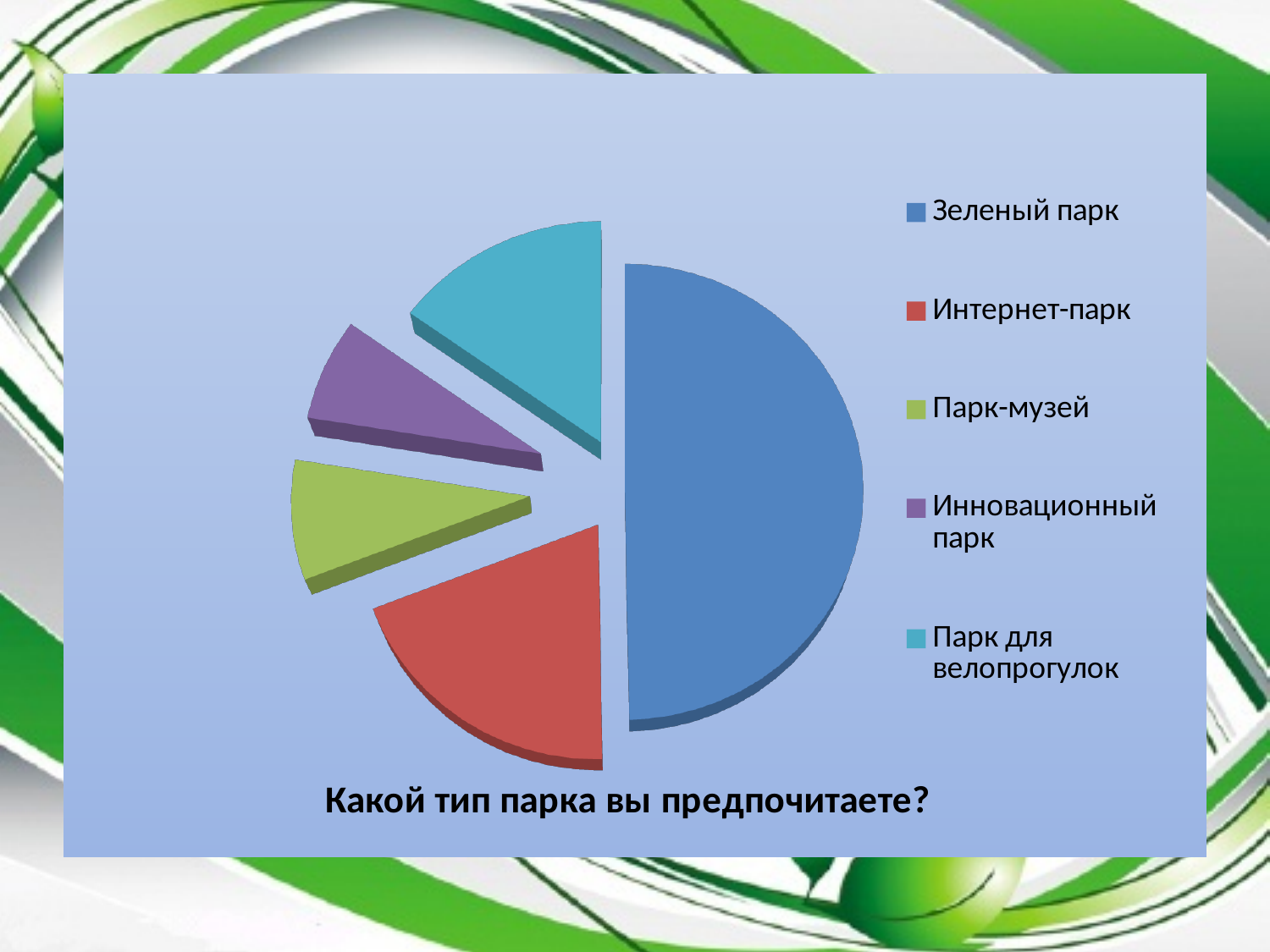
Which slice is larger: Зеленый парк or Парк для велопрогулок? Зеленый парк Which slice is larger: Интернет-парк or Парк-музей? Интернет-парк Which slice is larger: Парк для велопрогулок or Инновационный парк? Парк для велопрогулок Which park type has the largest slice of the pie? Зеленый парк What colour is the slice for Зеленый парк? Blue What is the title of the chart? Какой тип парка вы предпочитаете? How many slices does the pie chart have? 5 What kind of chart is shown on the slide? Pie chart How many entries does the legend list? 5